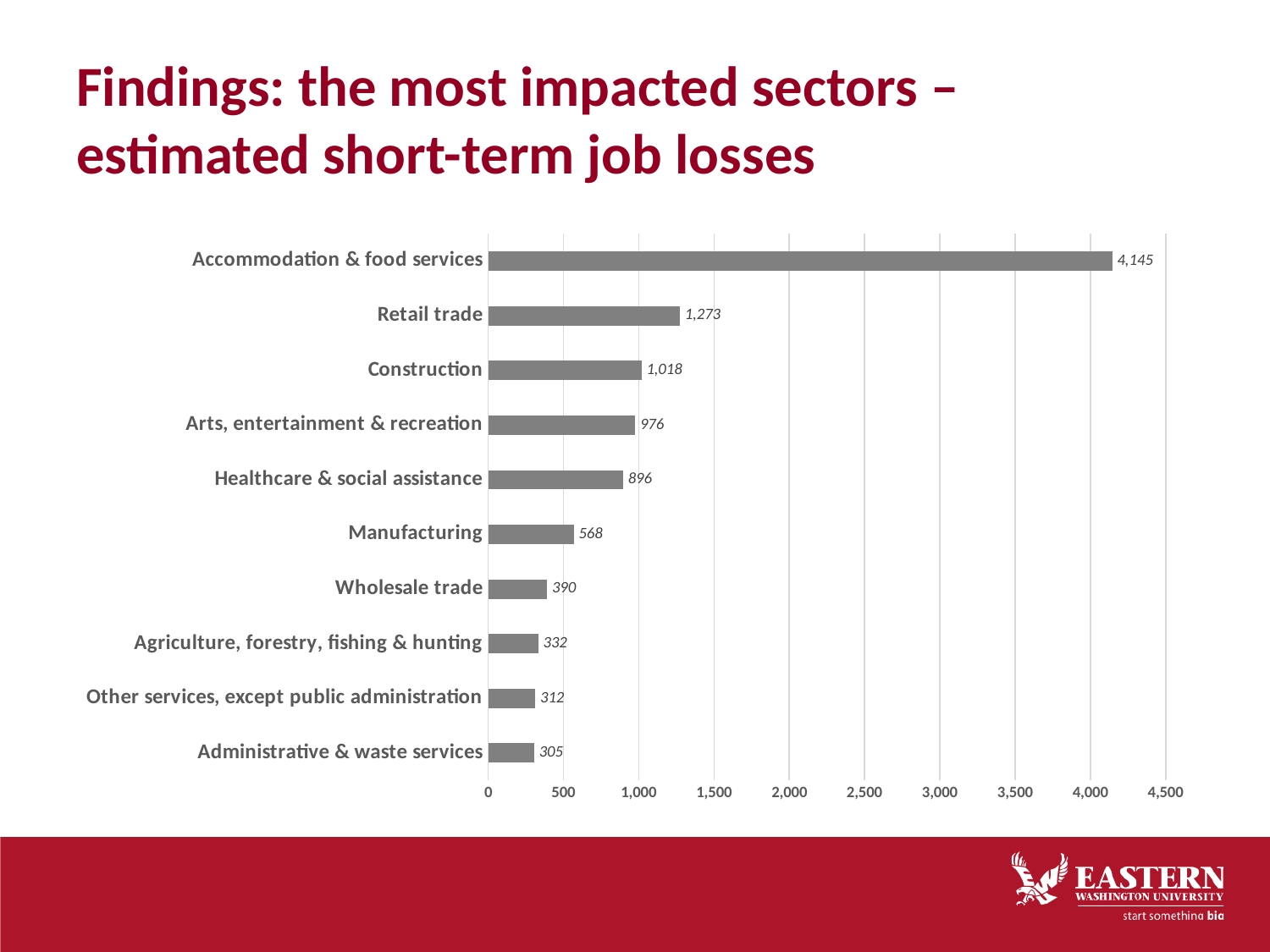
What is the value shown for Wholesale trade? 390 What is the difference between the values for Accommodation & food services and Retail trade? 2,872 What is the estimated short-term job loss for Retail trade? 1,273 Which sector has the highest estimated short-term job losses? Accommodation & food services What is the value shown for Healthcare & social assistance? 896 What is the maximum value shown on the horizontal axis? 4,500 Which has a larger value, Arts, entertainment & recreation or Healthcare & social assistance? Arts, entertainment & recreation Which sector has the lowest estimated short-term job losses? Administrative & waste services What is the difference between the values for Construction and Manufacturing? 450 How many sectors are shown in the chart? 10 What kind of chart is shown on the slide? Bar chart Is the value for Manufacturing greater or less than 500? greater